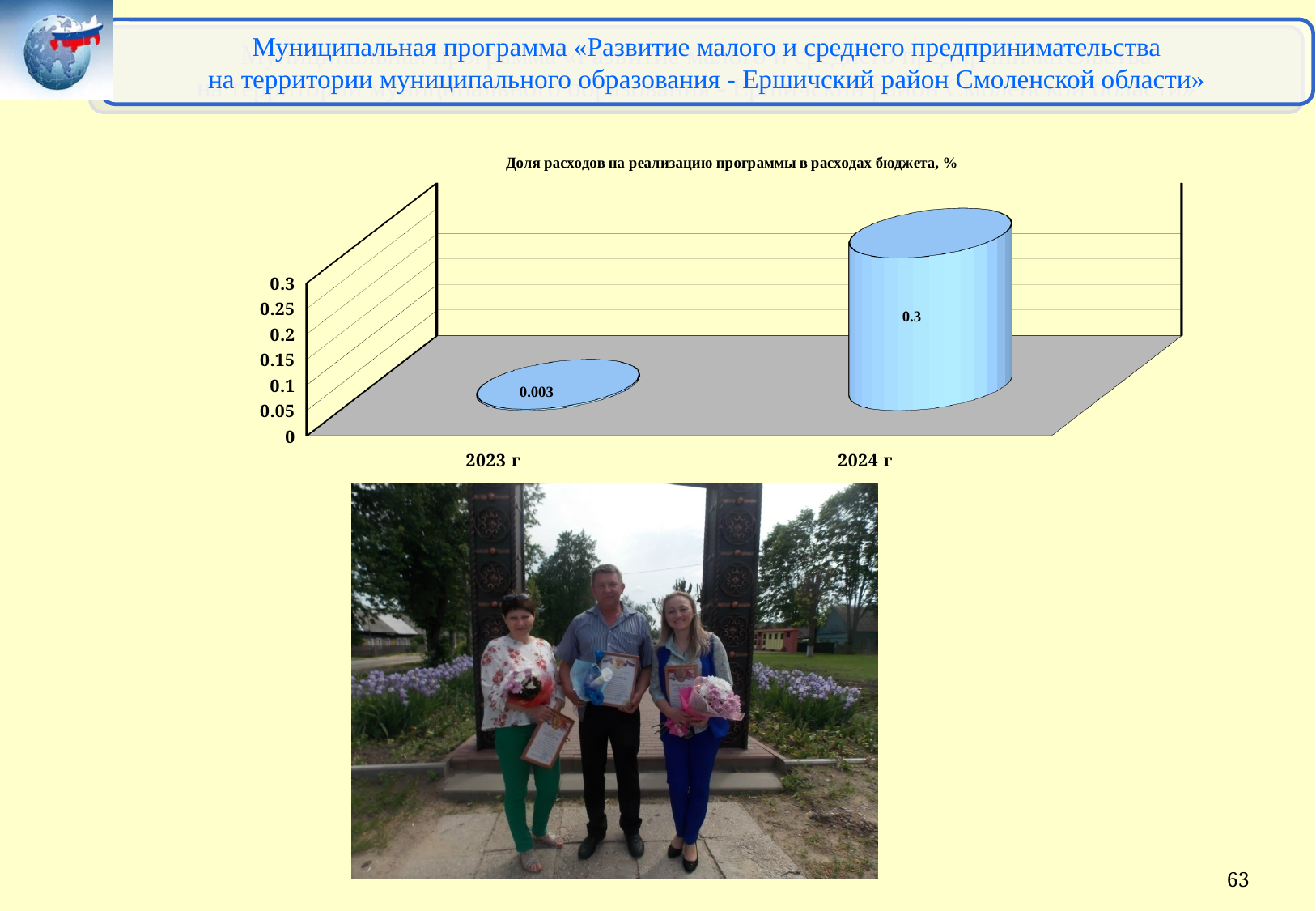
What kind of chart is shown on the slide? Bar chart Is the value for 2024 г greater or less than 0.2? greater What is the difference between the values for 2024 г and 2023 г? 0.297 What is the title of the chart? Доля расходов на реализацию программы в расходах бюджета, % How many categories are shown on the chart? 2 Which year has the highest value? 2024 г Do the values rise or fall from 2023 г to 2024 г? Rise What is the value for 2023 г? 0.003 Which is larger, the value for 2023 г or the value for 2024 г? 2024 г Is the value for 2023 г greater or less than 0.05? less Which year has the lowest value? 2023 г What is the value for 2024 г? 0.3